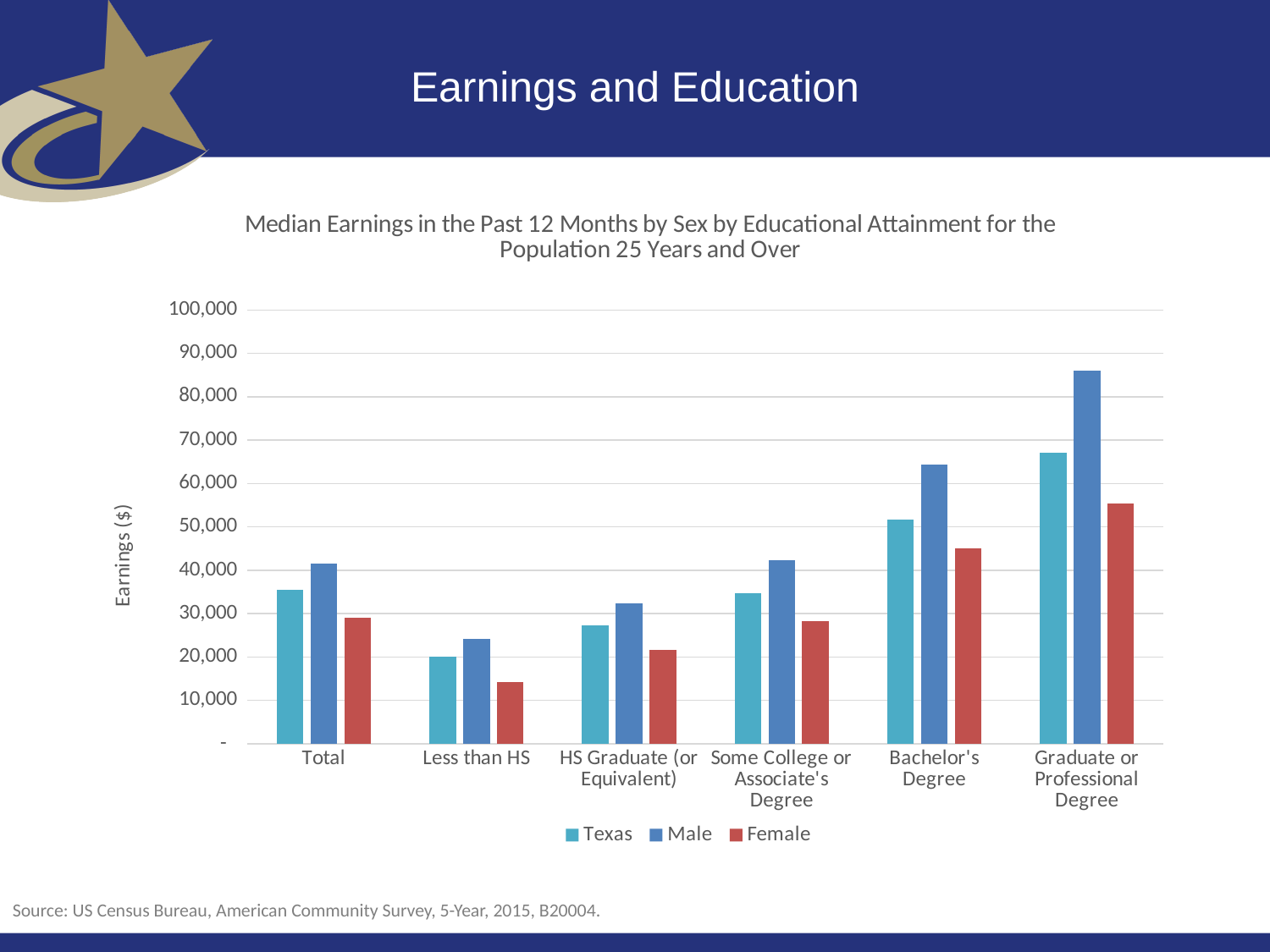
Do the Male median earnings rise or fall moving from Less than HS to Graduate or Professional Degree? rise For Bachelor's Degree, which is larger: the Male value or the Female value? Male Which category has the lowest Female median earnings? Less than HS Is the Female value for Graduate or Professional Degree greater or less than 50,000? greater How many educational attainment categories are shown on the x axis? 6 What is the label on the vertical axis of the chart? Earnings ($) Is the Female value for Less than HS greater or less than 20,000? less Is the Male value for Bachelor's Degree greater or less than 60,000? greater What kind of chart is shown on the slide? bar chart How many series does the legend list? 3 Which category has the highest Male median earnings? Graduate or Professional Degree